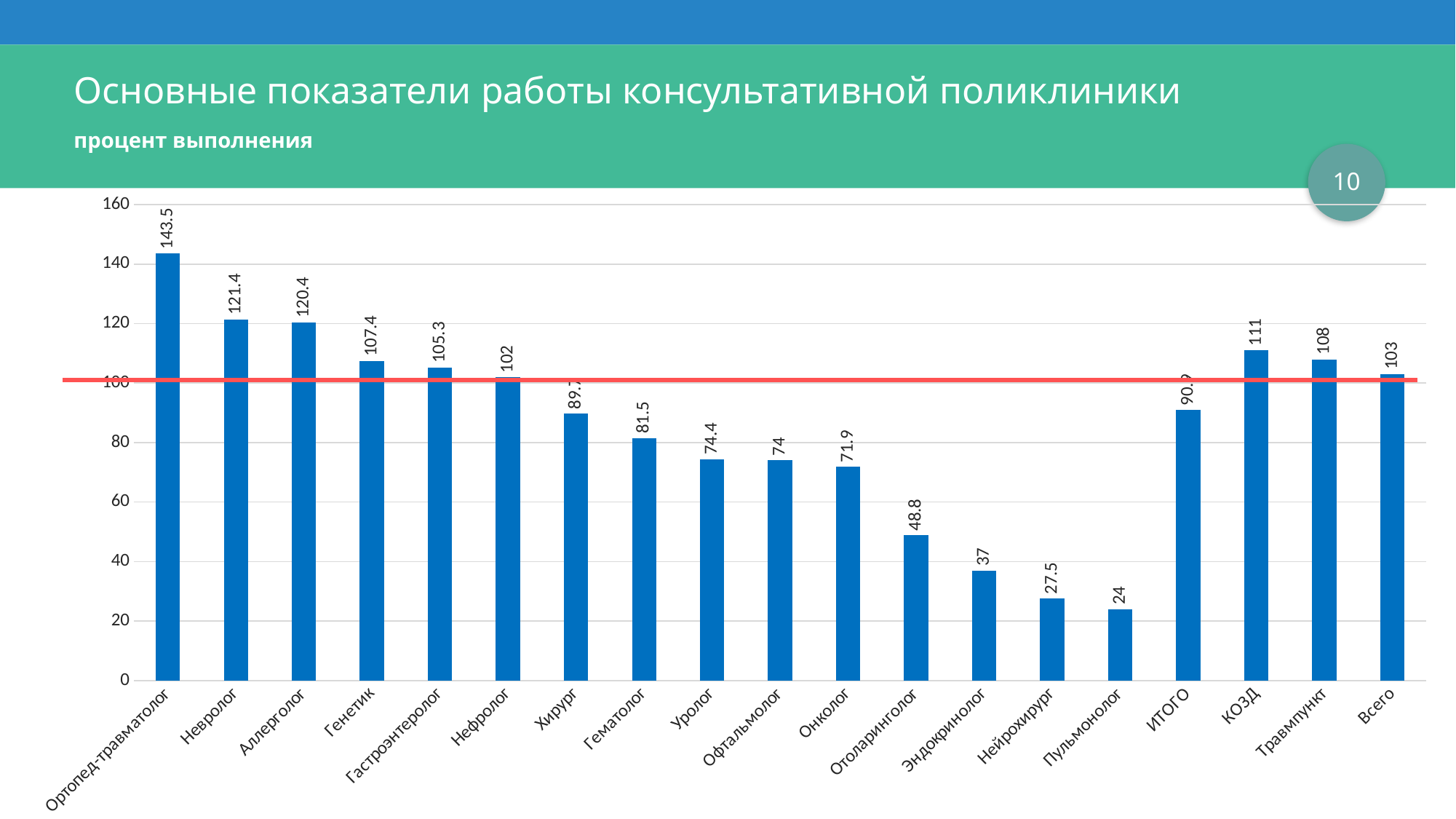
Which is larger, the value for Травмпункт or the value for Генетик? Травмпункт Is the value for Хирург greater or less than 100? less Which category has the highest value? Ортопед-травматолог How many categories are shown on the x axis? 19 What kind of chart is shown on the slide? bar chart What is the value for Ортопед-травматолог? 143.5 What is the difference between the values for Невролог and Аллерголог? 1 What is the value for Пульмонолог? 24 What is the value for КОЗД? 111 Which category has the lowest value? Пульмонолог What is the value for Всего? 103 Is the value for ИТОГО greater or less than 100? less